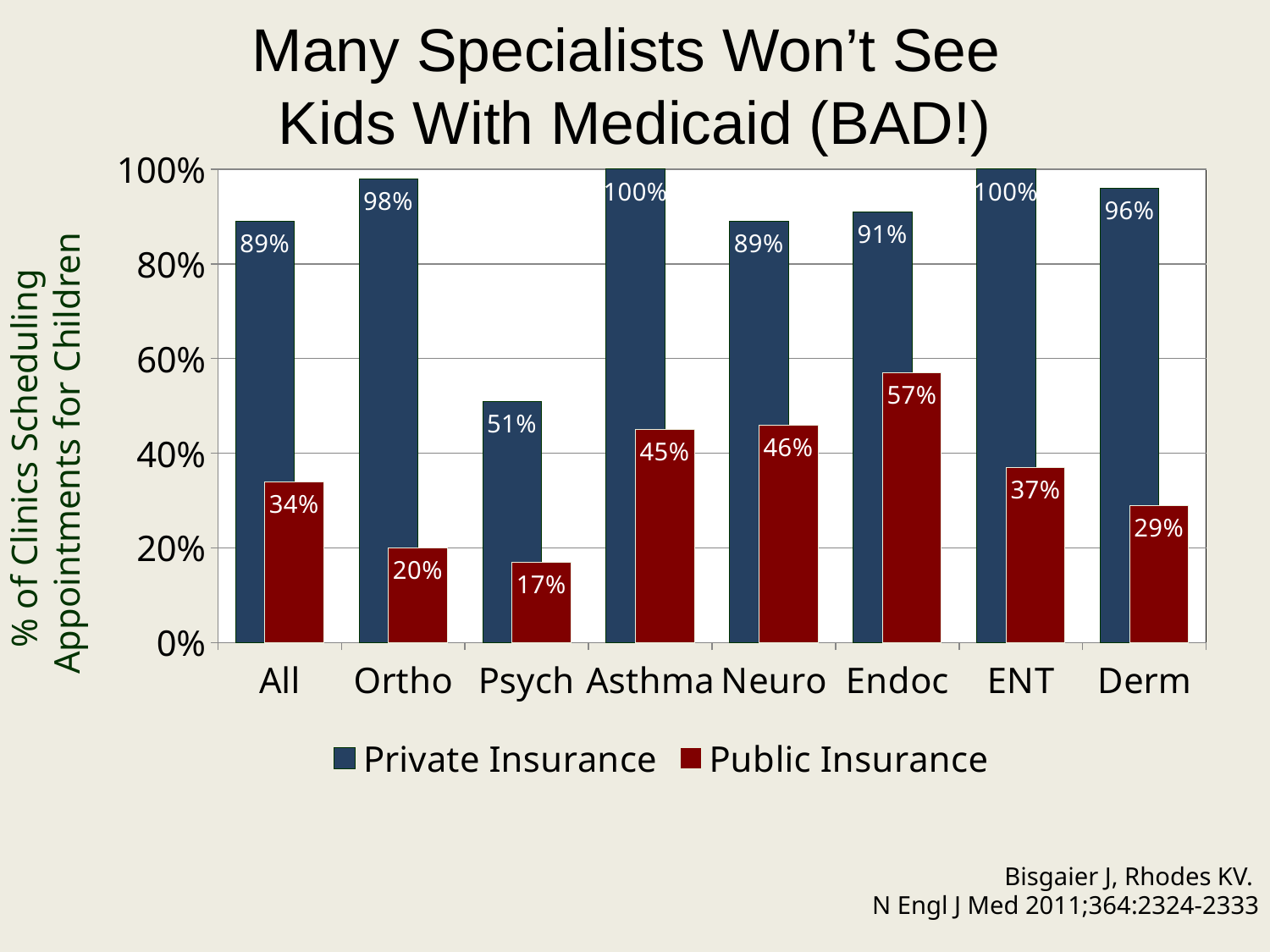
Which category has the highest Public Insurance value? Endoc What is the difference between the Private Insurance and Public Insurance values for Derm? 67% Which is larger, the Public Insurance value for Neuro or for ENT? Neuro What is the Private Insurance value for Ortho? 98% What is the Public Insurance value for Psych? 17% What kind of chart is shown on the slide? bar chart What is the Public Insurance value for Endoc? 57% How many series does the legend list? 2 Is the Public Insurance value for All greater or less than 40%? less What is the label of the y axis? % of Clinics Scheduling Appointments for Children Which category has the lowest Private Insurance value? Psych How many categories are shown on the x axis? 8